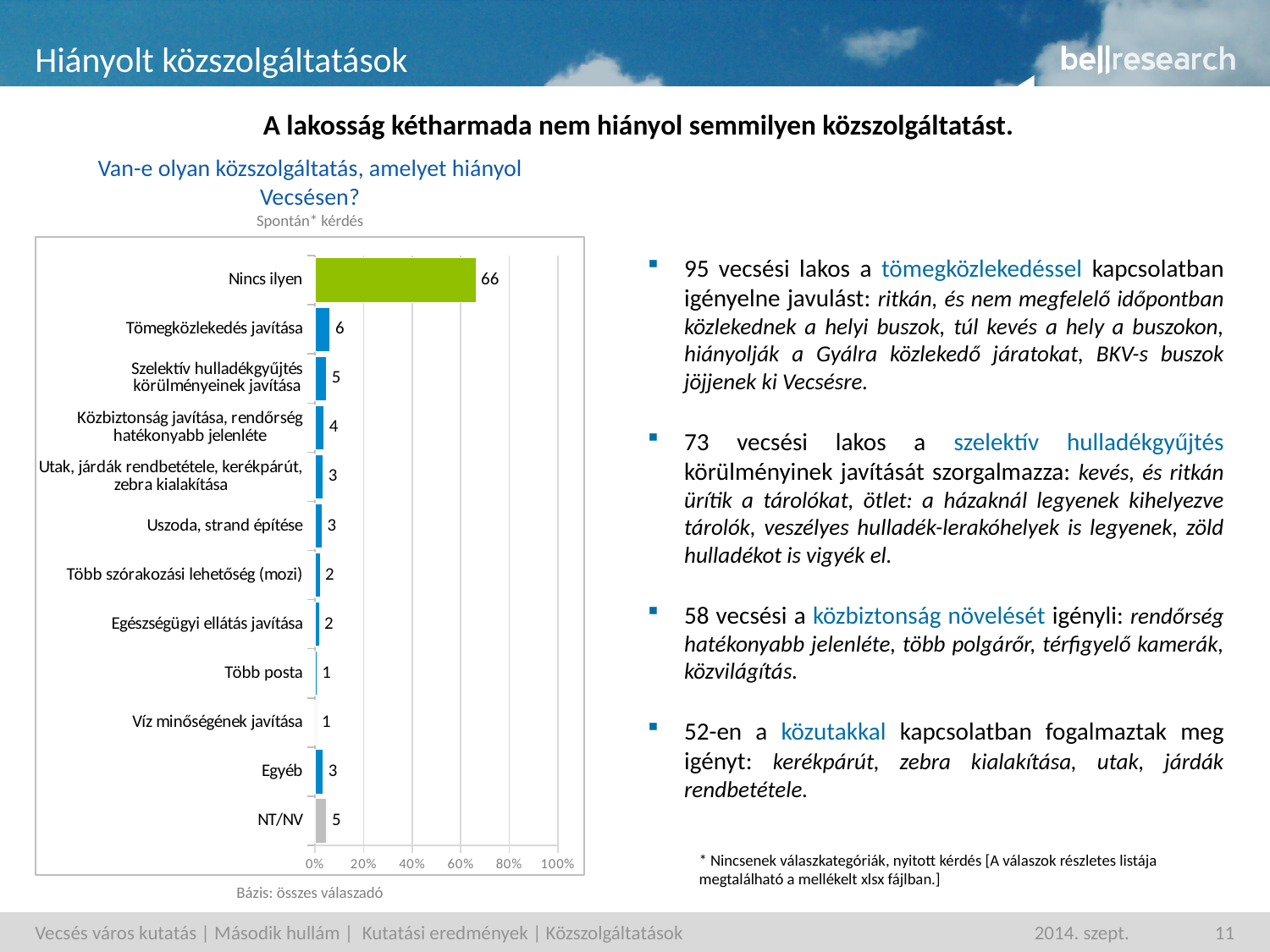
Is the value for "Nincs ilyen" greater or less than 60%? greater What value is shown for "NT/NV"? 5 What is the difference between the values for "Nincs ilyen" and "Tömegközlekedés javítása"? 60 How many categories are shown in the chart? 12 What value is shown for "Tömegközlekedés javítása"? 6 What is the difference between the values for "Közbiztonság javítása, rendőrség hatékonyabb jelenléte" and "Több posta"? 3 What value is shown for "Nincs ilyen"? 66 Which category has the highest value? Nincs ilyen What is the title of the chart? Van-e olyan közszolgáltatás, amelyet hiányol Vecsésen? Which is larger, the value for "Szelektív hulladékgyűjtés körülményeinek javítása" or the value for "Uszoda, strand építése"? Szelektív hulladékgyűjtés körülményeinek javítása What kind of chart is shown on the slide? Bar chart What value is shown for "Egészségügyi ellátás javítása"? 2